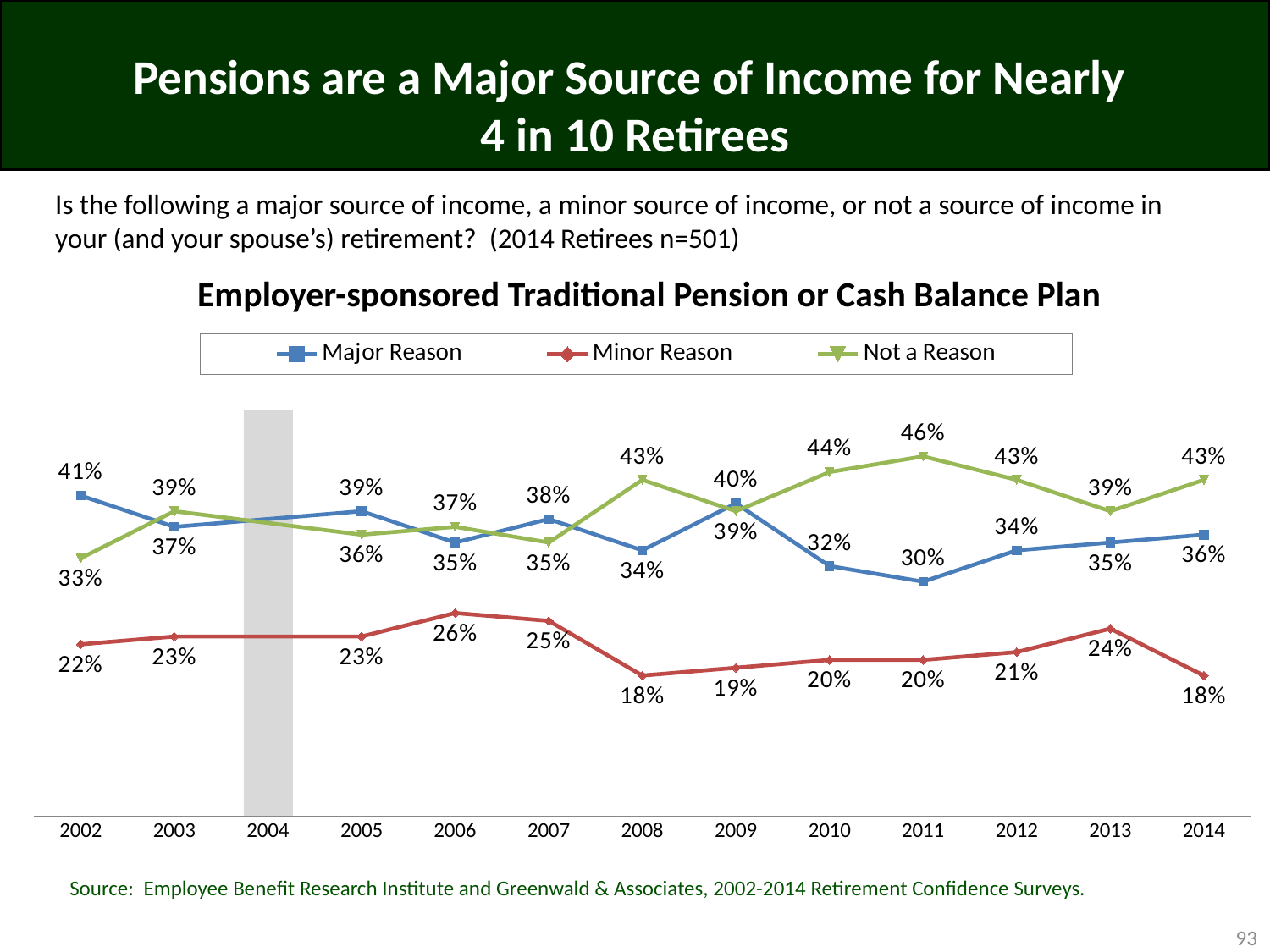
How many years are labelled on the x axis? 13 What is the value for Major Reason in 2002? 41% What kind of chart is shown on the slide? line chart What is the value for Not a Reason in 2011? 46% What is the value for Minor Reason in 2014? 18% How many series does the legend list? 3 What is the value for Minor Reason in 2006? 26% In which year is the Major Reason series at its lowest? 2011 In 2014, what is the difference between Not a Reason and Major Reason? 7 percentage points Does the Minor Reason series rise or fall from 2013 to 2014? fall In which year is the Not a Reason series at its highest? 2011 In 2008, which is larger: Major Reason or Minor Reason? Major Reason